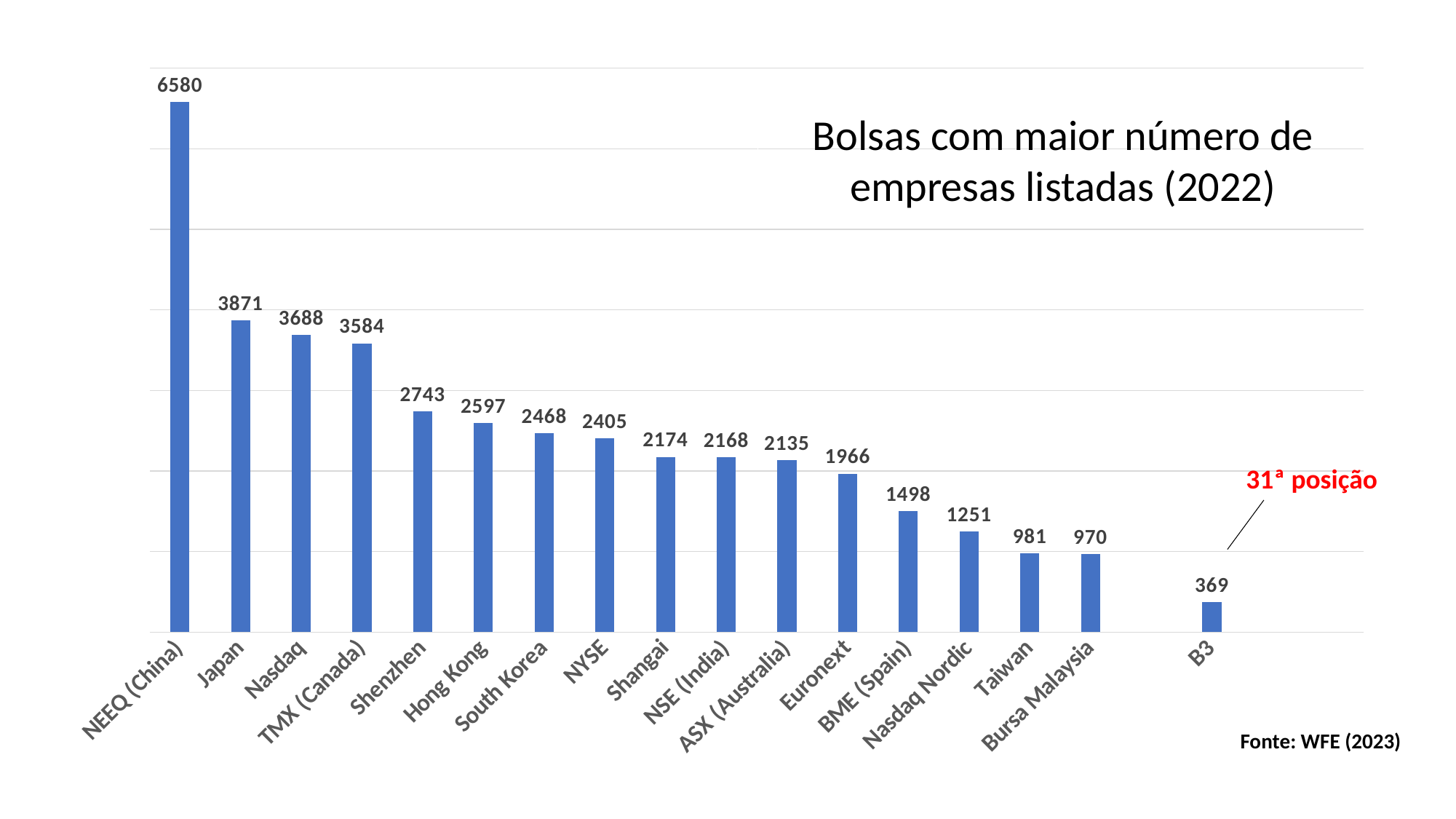
What is the value for B3? 369 What is the difference between the values for NEEQ (China) and B3? 6211 Which exchange has the lowest number of listed companies? B3 How many exchanges are shown in the chart? 17 What is the value for Euronext? 1966 What kind of chart is shown on the slide? Bar chart What is the title of the chart? Bolsas com maior número de empresas listadas (2022) What is the difference between the values for Japan and Nasdaq? 183 What is the value for NEEQ (China)? 6580 Which is larger, the value for Taiwan or the value for BME (Spain)? BME (Spain) Which exchange has the highest number of listed companies? NEEQ (China) Which is larger, the value for Shenzhen or the value for Hong Kong? Shenzhen